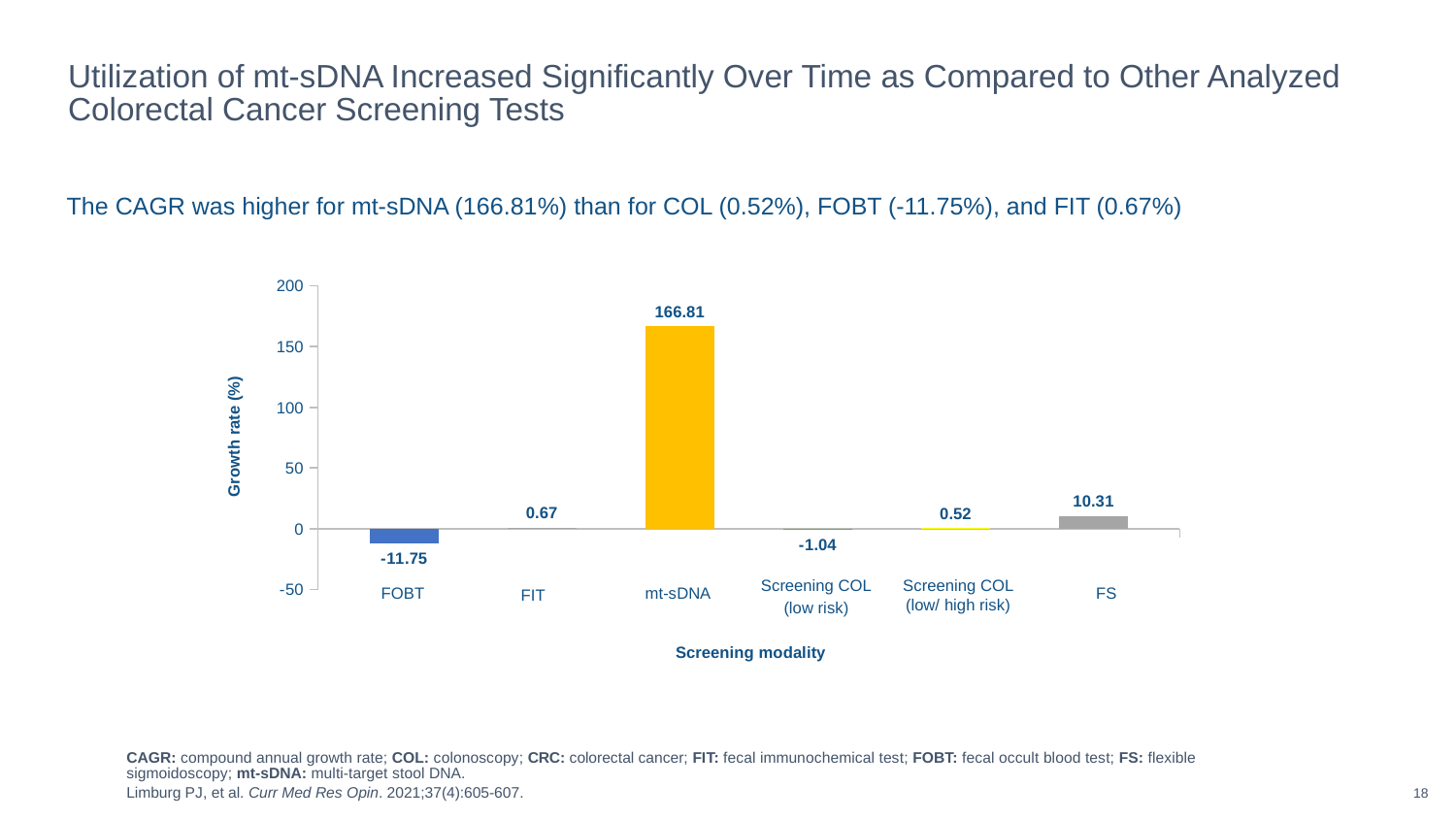
What is the label of the y axis? Growth rate (%) What is the growth rate for FOBT? -11.75 How many screening modalities are shown on the x axis? 6 Which screening modality has the lowest growth rate? FOBT What is the growth rate for FS? 10.31 Which has a higher growth rate, FIT or Screening COL (low/ high risk)? FIT What kind of chart is shown on the slide? bar chart What is the growth rate for mt-sDNA? 166.81 What is the difference between the growth rate for mt-sDNA and the growth rate for FS? 156.5 Is the growth rate for mt-sDNA greater or less than 150? greater Which screening modality has the highest growth rate? mt-sDNA What is the growth rate for Screening COL (low risk)? -1.04